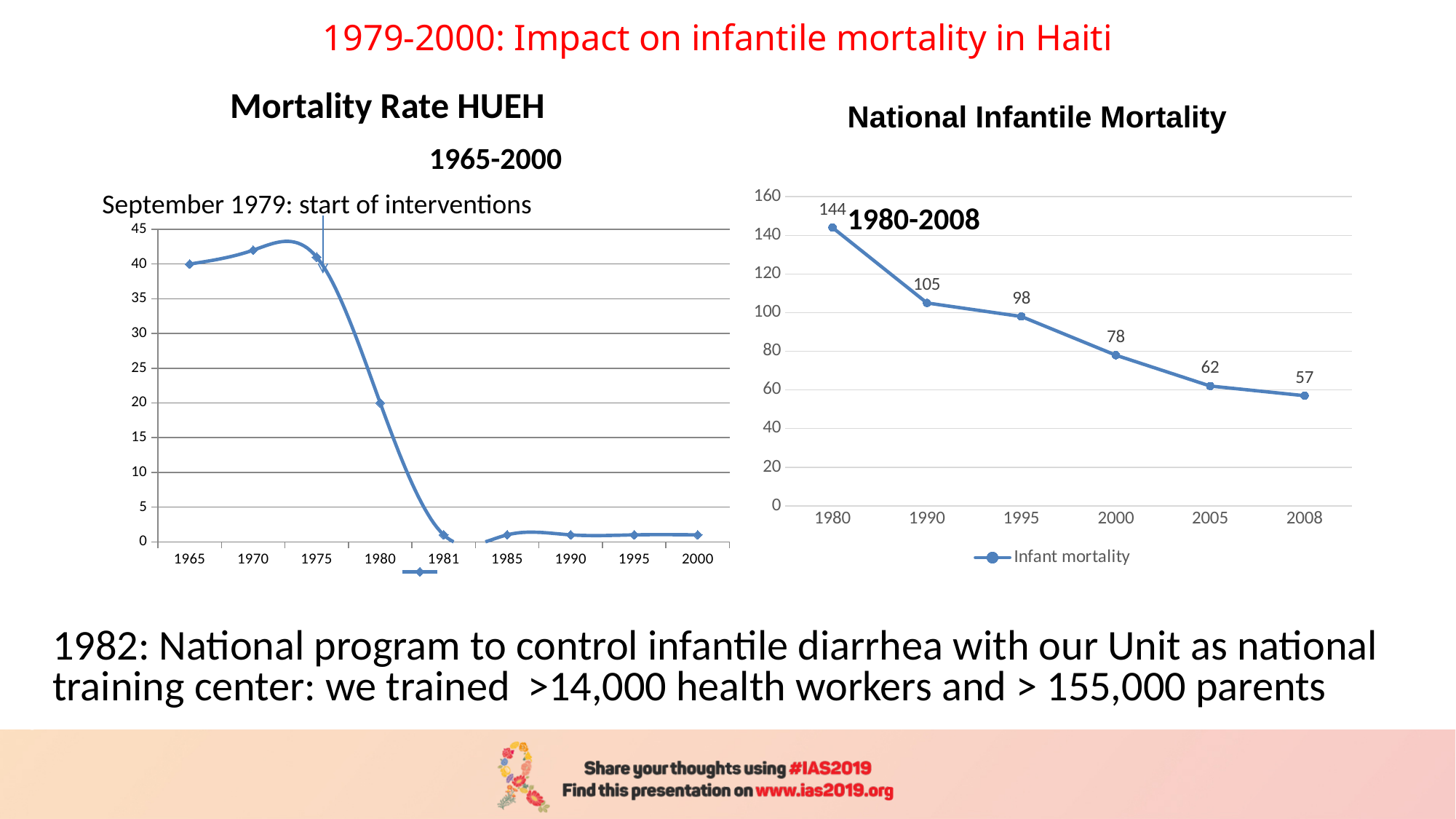
In the National Infantile Mortality chart, what is the value for 2008? 57 In the National Infantile Mortality chart, which year has the highest infant mortality? 1980 In the National Infantile Mortality chart, how many data points are plotted? 6 In the Mortality Rate HUEH chart, which is larger, the value for 1970 or the value for 1980? 1970 In the National Infantile Mortality chart, what series name does the legend show? Infant mortality In the Mortality Rate HUEH chart, is the value for 1975 greater or less than 35? greater What kind of chart is the Mortality Rate HUEH chart? line chart In the National Infantile Mortality chart, do the values rise or fall from 1980 to 2008? fall In the National Infantile Mortality chart, what is the difference between the 1980 value and the 1990 value? 39 In the National Infantile Mortality chart, what is the value for 2000? 78 In the National Infantile Mortality chart, which year has the lowest infant mortality? 2008 In the National Infantile Mortality chart, what is the infant mortality value for 1980? 144